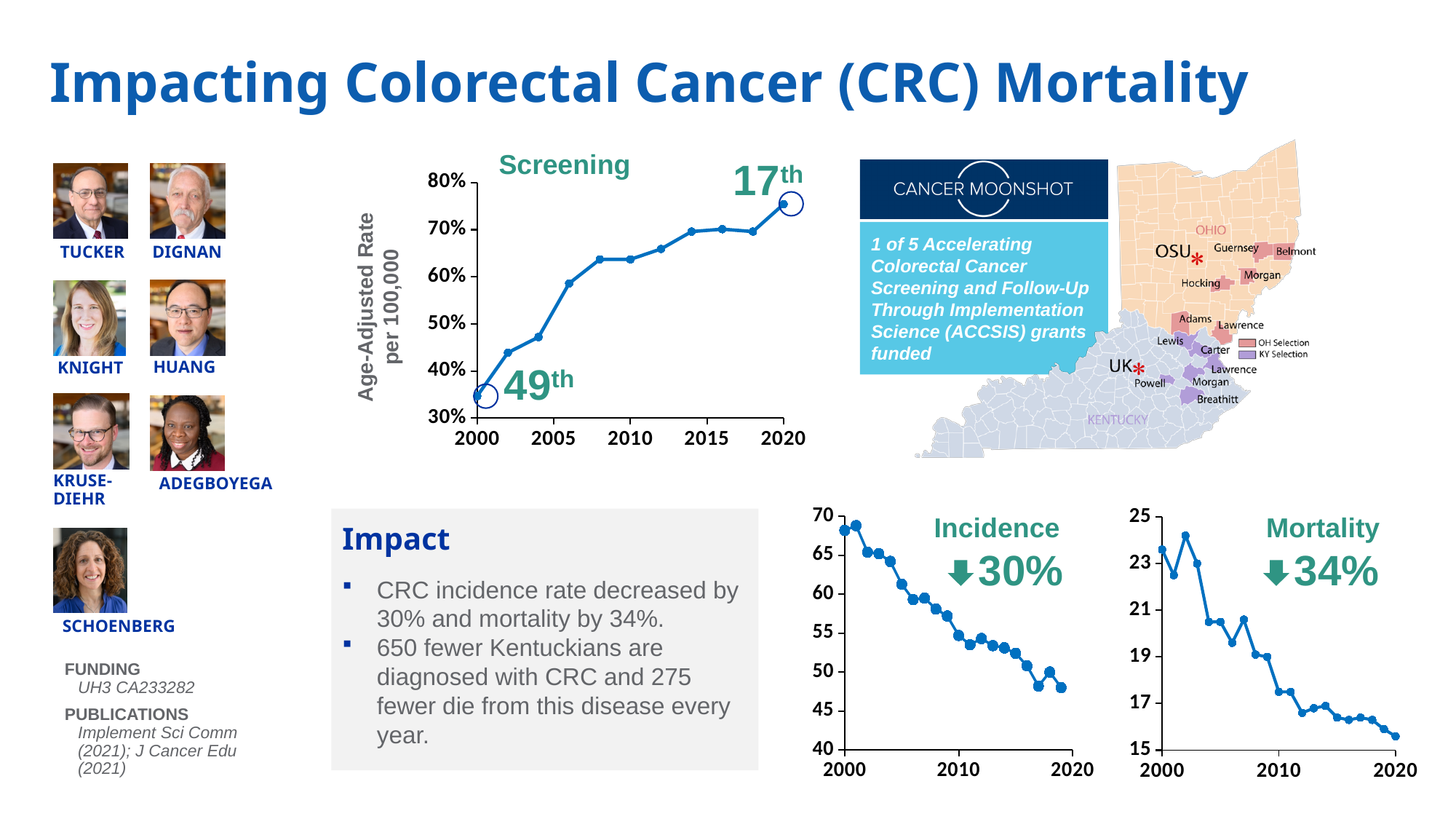
In the Screening chart, is the value for 2020 greater or less than 70%? greater What kind of chart is the Screening chart? line chart In the Incidence chart, do the values rise or fall from 2000 to 2020? fall In the Mortality chart, is the last plotted value greater or less than 17? less In the Incidence chart, is the last plotted value greater or less than 50? less In the Screening chart, which year has the higher value, 2000 or 2020? 2020 In the Mortality chart, do the values rise or fall from 2000 to 2020? fall What percentage decrease is annotated on the Mortality chart? 34% What percentage decrease is annotated on the Incidence chart? 30% In the Screening chart, do the values rise or fall from 2000 to 2020? rise